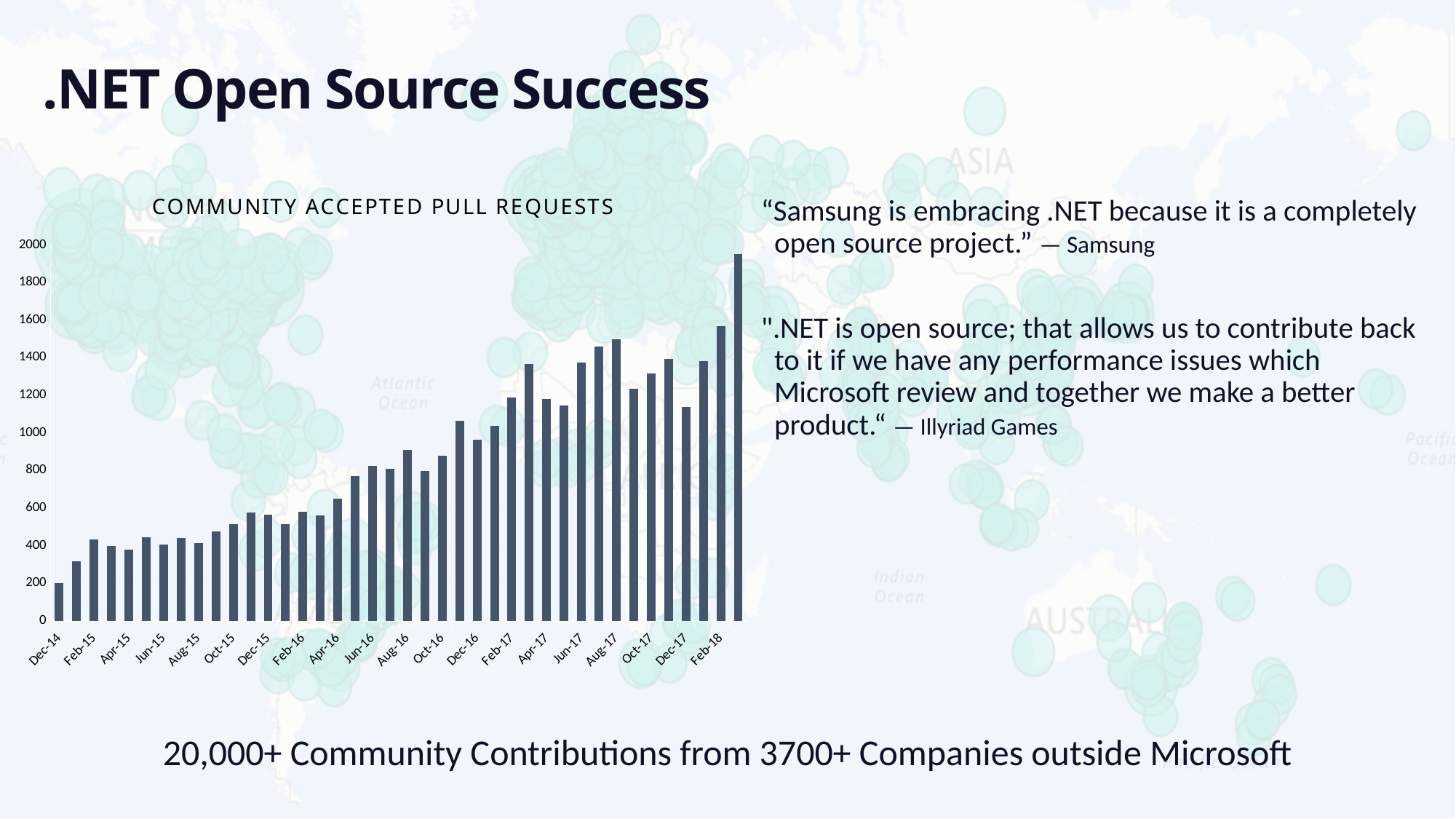
Which is larger, the value for Feb-18 or the value for Dec-17? Feb-18 Which month has the lowest number of community accepted pull requests? Dec-14 Is the value for Dec-14 greater or less than 400? less Is the value for Oct-15 greater or less than 600? less Is the value for Aug-17 greater or less than 1200? greater Do the values generally rise or fall from Dec-14 to Feb-18? rise What is the title of the chart? COMMUNITY ACCEPTED PULL REQUESTS Which month has the highest number of community accepted pull requests? Mar-18 What kind of chart is shown on the slide? bar chart Which is larger, the value for Aug-17 or the value for Oct-17? Aug-17